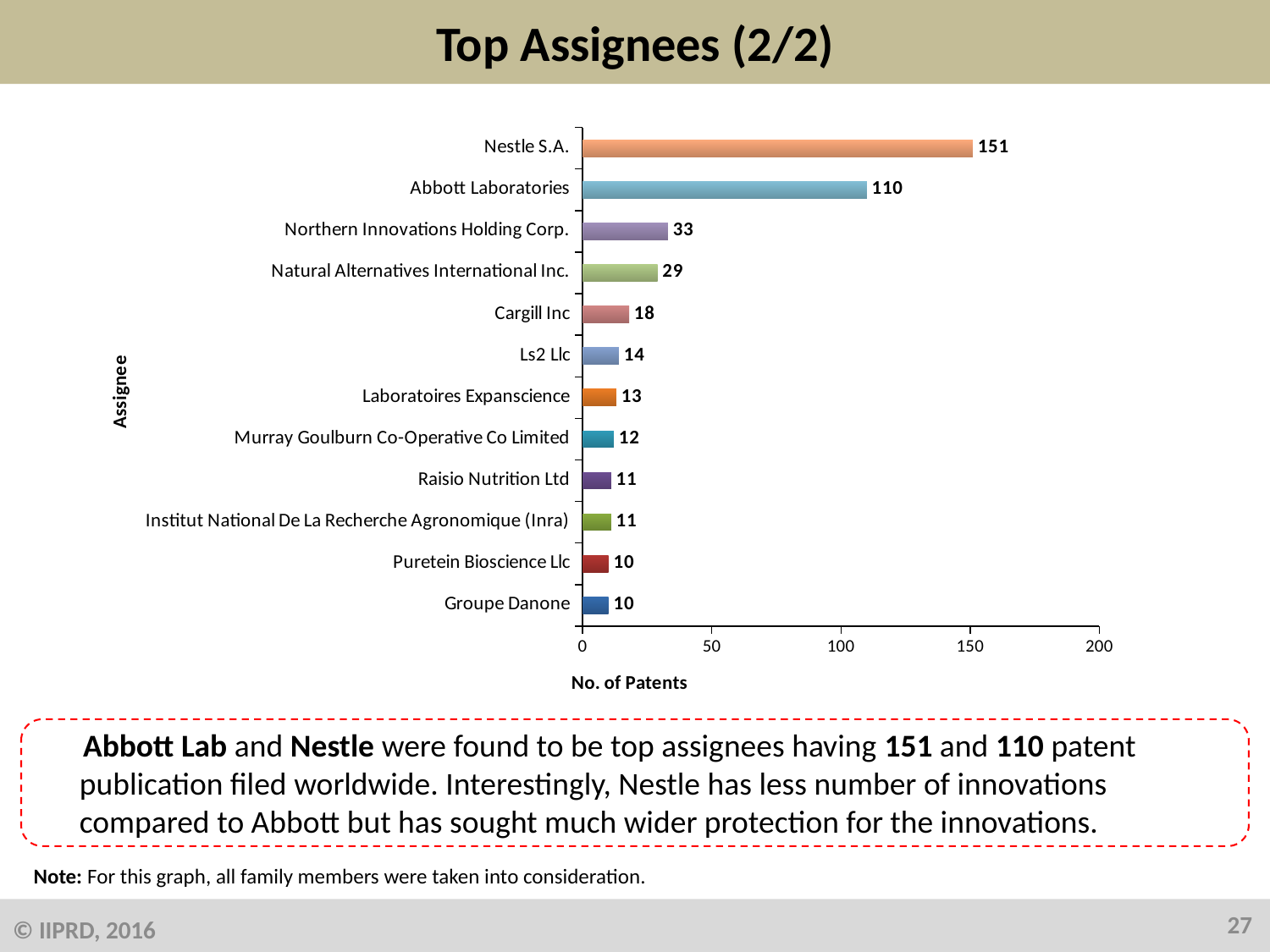
What is the label of the horizontal axis? No. of Patents How many patents does Nestle S.A. have according to the chart? 151 What is the difference in number of patents between Nestle S.A. and Abbott Laboratories? 41 What is the label of the vertical axis? Assignee How many patents does Cargill Inc have? 18 Which has more patents, Natural Alternatives International Inc. or Cargill Inc? Natural Alternatives International Inc. How many assignees are listed in the chart? 12 Which assignee has the highest number of patents? Nestle S.A. What is the value shown for Northern Innovations Holding Corp.? 33 What type of chart is shown on the slide? Bar chart Is the value for Abbott Laboratories greater or less than 100? greater What is the number of patents for Abbott Laboratories? 110